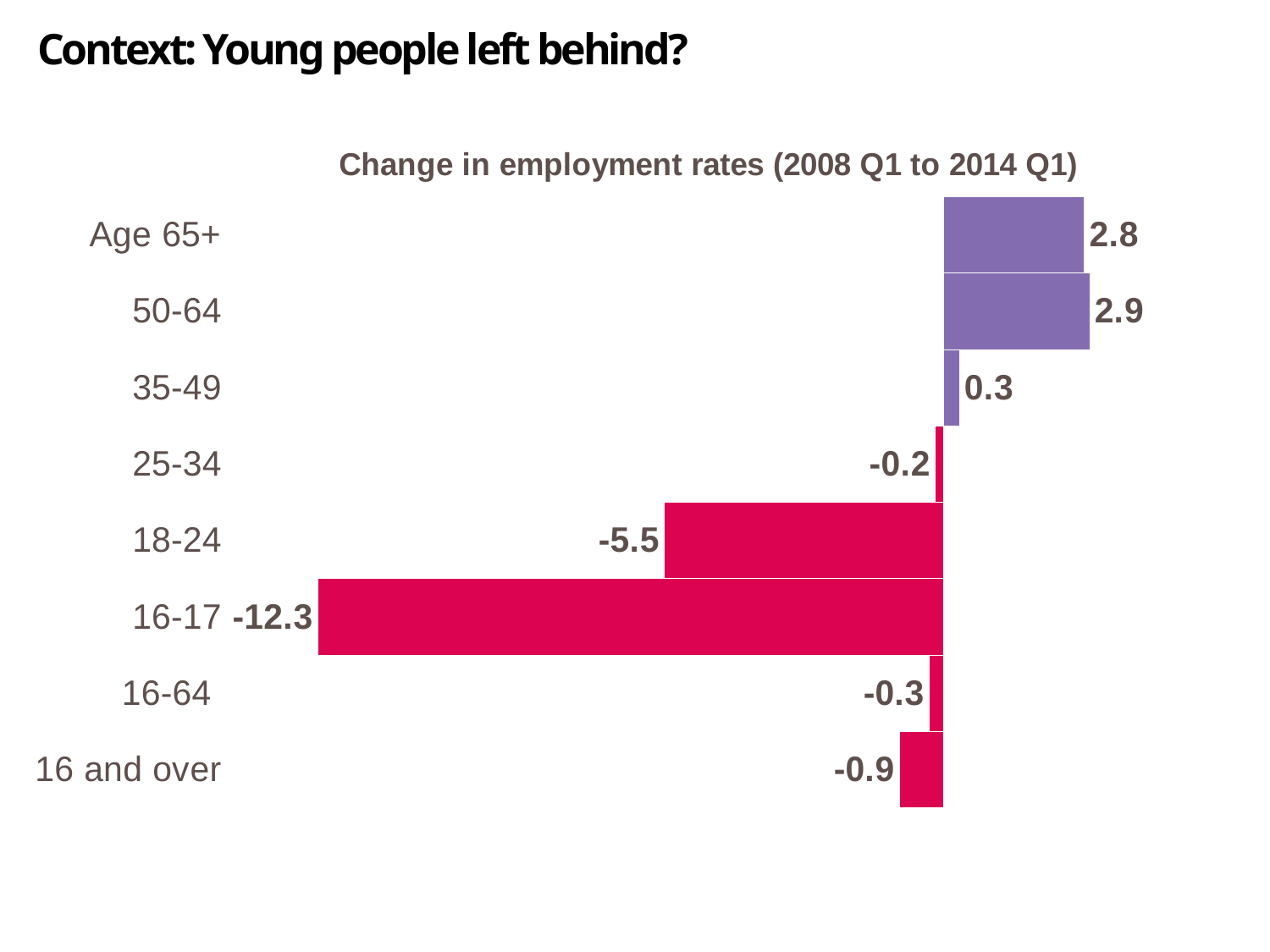
What is the change in employment rate for the 16 and over group? -0.9 What is the title of the chart? Change in employment rates (2008 Q1 to 2014 Q1) What kind of chart is shown on the slide? Bar chart What is the change in employment rate for the 50-64 age group? 2.9 How many age groups are shown in the chart? 8 What is the difference between the change in employment rate for 18-24 and for 16-17? 6.8 Which age group has the highest change in employment rate? 50-64 What colour are the bars with negative values? Red What is the change in employment rate for the 16-17 age group? -12.3 Which age group has the lowest change in employment rate? 16-17 What is the change in employment rate for the 18-24 age group? -5.5 Which has a larger change in employment rate, Age 65+ or 35-49? Age 65+